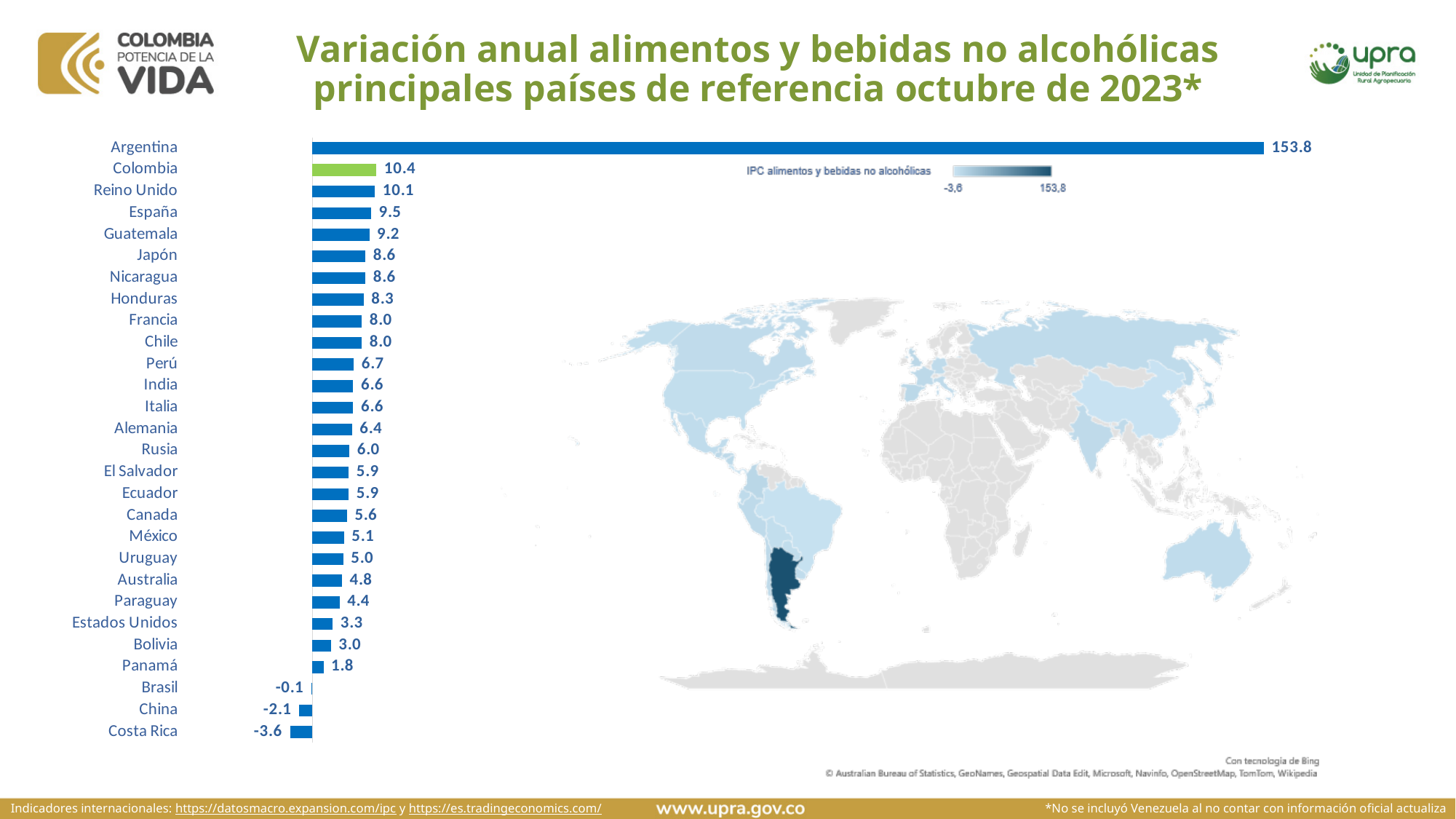
In the bar chart, what is the difference between the values for Colombia and Reino Unido? 0.3 In the bar chart, what is the value for Estados Unidos? 3.3 What kind of chart is used to show the values by country on the left of the slide? Bar chart In the bar chart, what is the value for Costa Rica? -3.6 In the bar chart, which country has the highest value? Argentina In the bar chart, which country has the lowest value? Costa Rica In the bar chart, what is the difference between the values for Argentina and Colombia? 143.4 In the bar chart, what is the value for Argentina? 153.8 In the bar chart, which has a larger value, España or Guatemala? España How many countries are shown in the bar chart? 28 In the bar chart, which country's bar is coloured green instead of blue? Colombia In the bar chart, what is the value for Colombia? 10.4